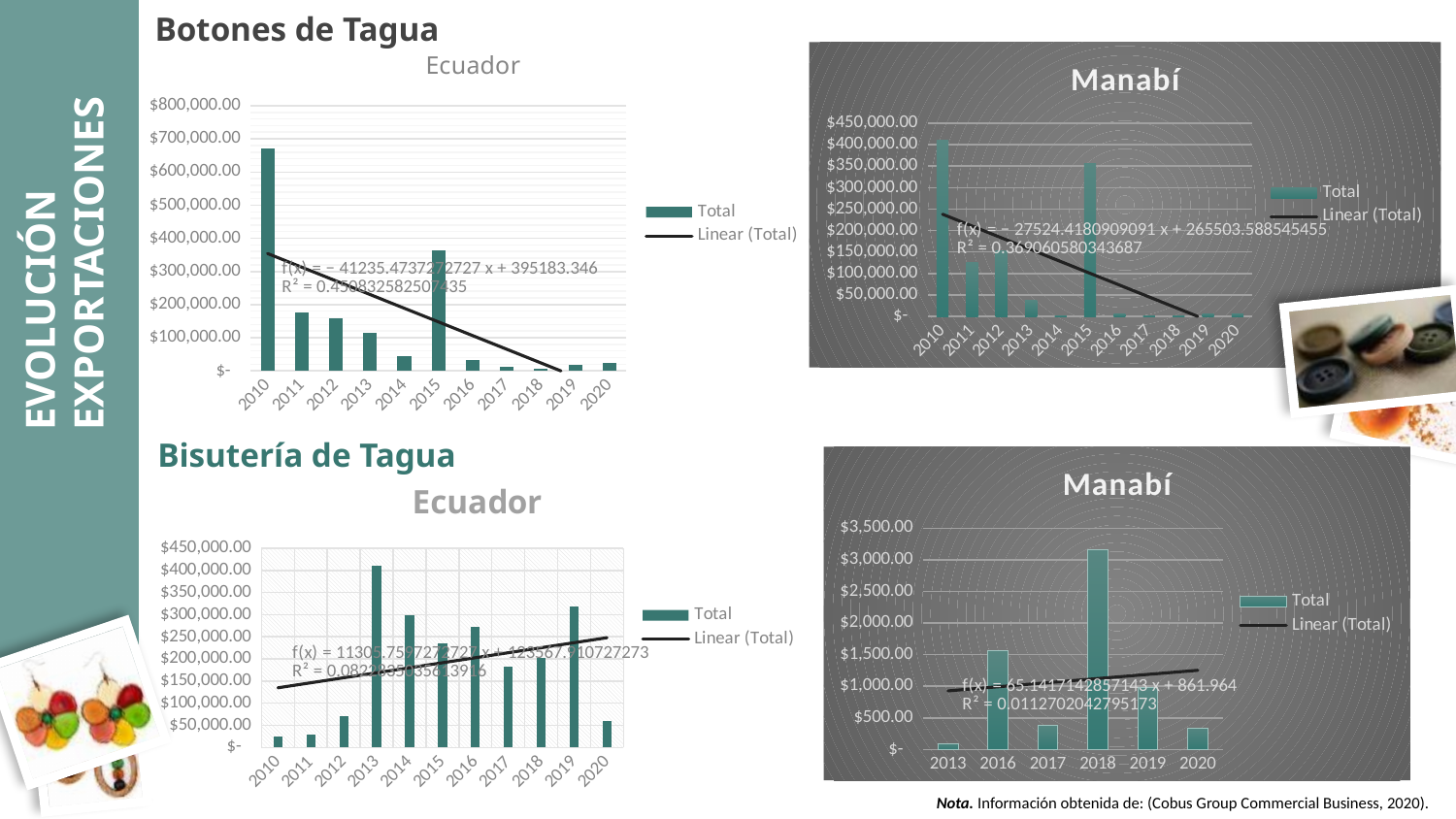
In the 'Ecuador' chart under 'Bisutería de Tagua' (bottom left), do the values generally rise or fall from 2010 to 2020 according to the trend line? rise In the 'Ecuador' chart under 'Botones de Tagua' (top left), which year has the highest value? 2010 In the bottom-right 'Manabí' chart (Bisutería de Tagua), which year has the highest value? 2018 In the 'Ecuador' chart under 'Botones de Tagua' (top left), how many years are shown on the x axis? 11 In the bottom-right 'Manabí' chart (Bisutería de Tagua), which year has the lowest value? 2013 In the 'Ecuador' chart under 'Botones de Tagua' (top left), how many entries does the legend list? 2 In the 'Ecuador' chart under 'Botones de Tagua' (top left), do the values generally rise or fall from 2010 to 2020? fall In the 'Ecuador' chart under 'Bisutería de Tagua' (bottom left), which year has the highest value? 2013 In the 'Ecuador' chart under 'Botones de Tagua' (top left), is the value for 2010 greater or less than $600,000.00? greater In the top-right 'Manabí' chart (Botones de Tagua), which is larger, the value for 2010 or the value for 2015? 2010 In the bottom-right 'Manabí' chart (Bisutería de Tagua), how many years are shown on the x axis? 6 In the top-right 'Manabí' chart (Botones de Tagua), is the value for 2015 greater or less than $300,000.00? greater